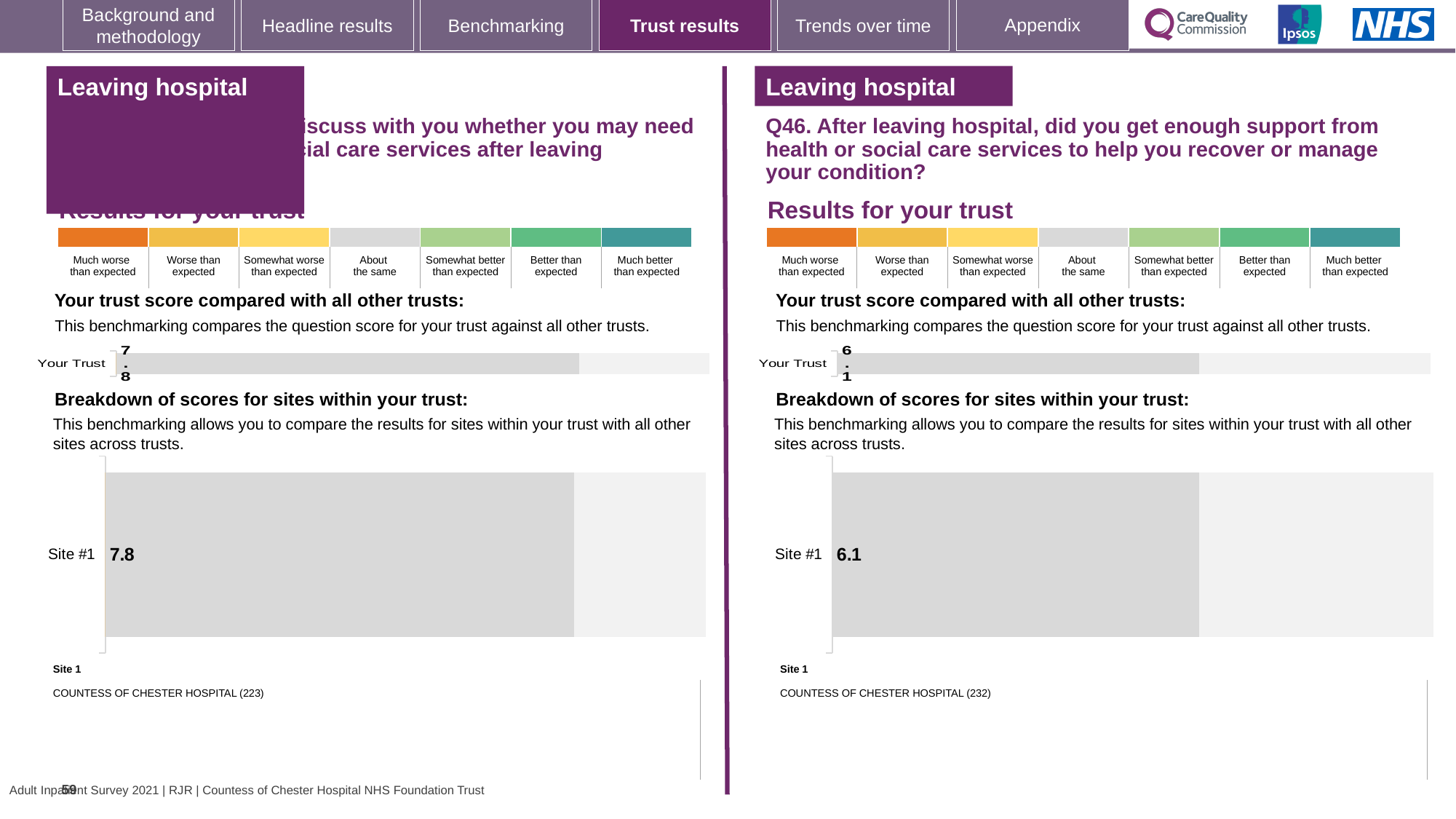
How many sites are shown in the left-hand breakdown of scores for sites within your trust? 1 What is the difference between the Your Trust score on the left-hand chart (7.8) and the Your Trust score on the right-hand chart (6.1)? 1.7 Which is larger: the Your Trust score on the left-hand chart or the Your Trust score on the right-hand chart (Q46)? Left-hand chart (7.8) Which hospital is listed as Site 1 beneath the right-hand site breakdown chart? COUNTESS OF CHESTER HOSPITAL (232) In the left-hand breakdown of scores for sites, what is the score for Site #1? 7.8 On the left-hand chart, what is the score shown for Your Trust? 7.8 Which question number does the right-hand chart report results for? Q46 In the right-hand breakdown of scores for sites (Q46), what is the score for Site #1? 6.1 On the right-hand chart (Q46), what is the score shown for Your Trust? 6.1 What is the difference between the Site #1 score on the left-hand chart (7.8) and the Site #1 score on the right-hand chart (6.1)? 1.7 Which is larger: the Site #1 score on the left-hand chart or the Site #1 score on the right-hand chart (Q46)? Left-hand chart (7.8) What kind of chart is used to show the Your Trust score on each half of the slide? Bar chart